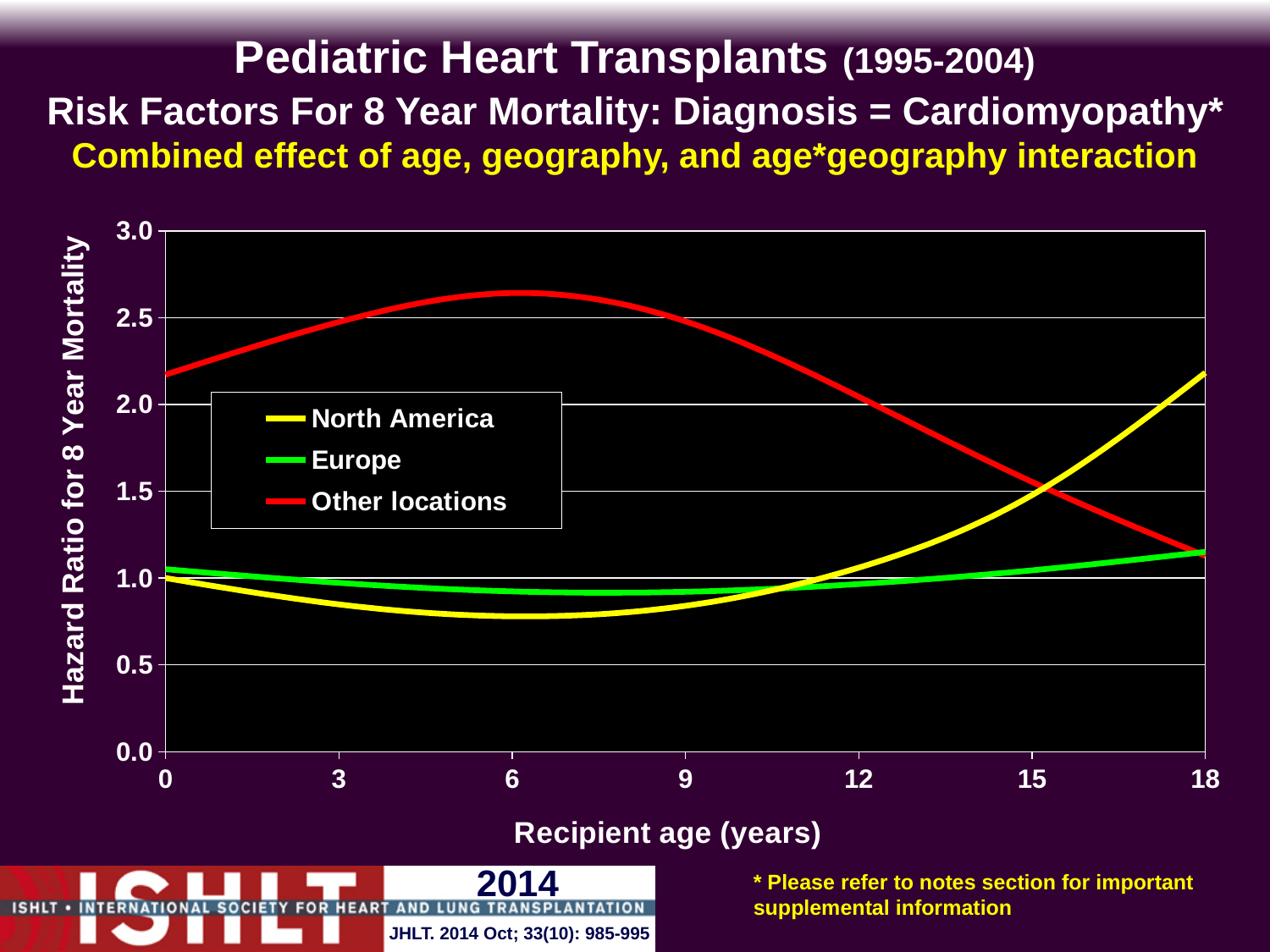
Which series is drawn in green? Europe Which series has the highest hazard ratio at recipient age 6? Other locations What kind of chart is shown on the slide? Line chart Does the Other locations line rise or fall between recipient age 9 and 18? Fall Is the value for North America at recipient age 6 greater or less than 1.0? less How many series does the legend list? 3 Is the value for Other locations at recipient age 12 greater or less than 2.5? less At recipient age 0, which is larger: the value for Other locations or the value for North America? Other locations Which series has the highest hazard ratio at recipient age 18? North America Is the value for Other locations at recipient age 6 greater or less than 2.5? greater What is the label of the y axis? Hazard Ratio for 8 Year Mortality